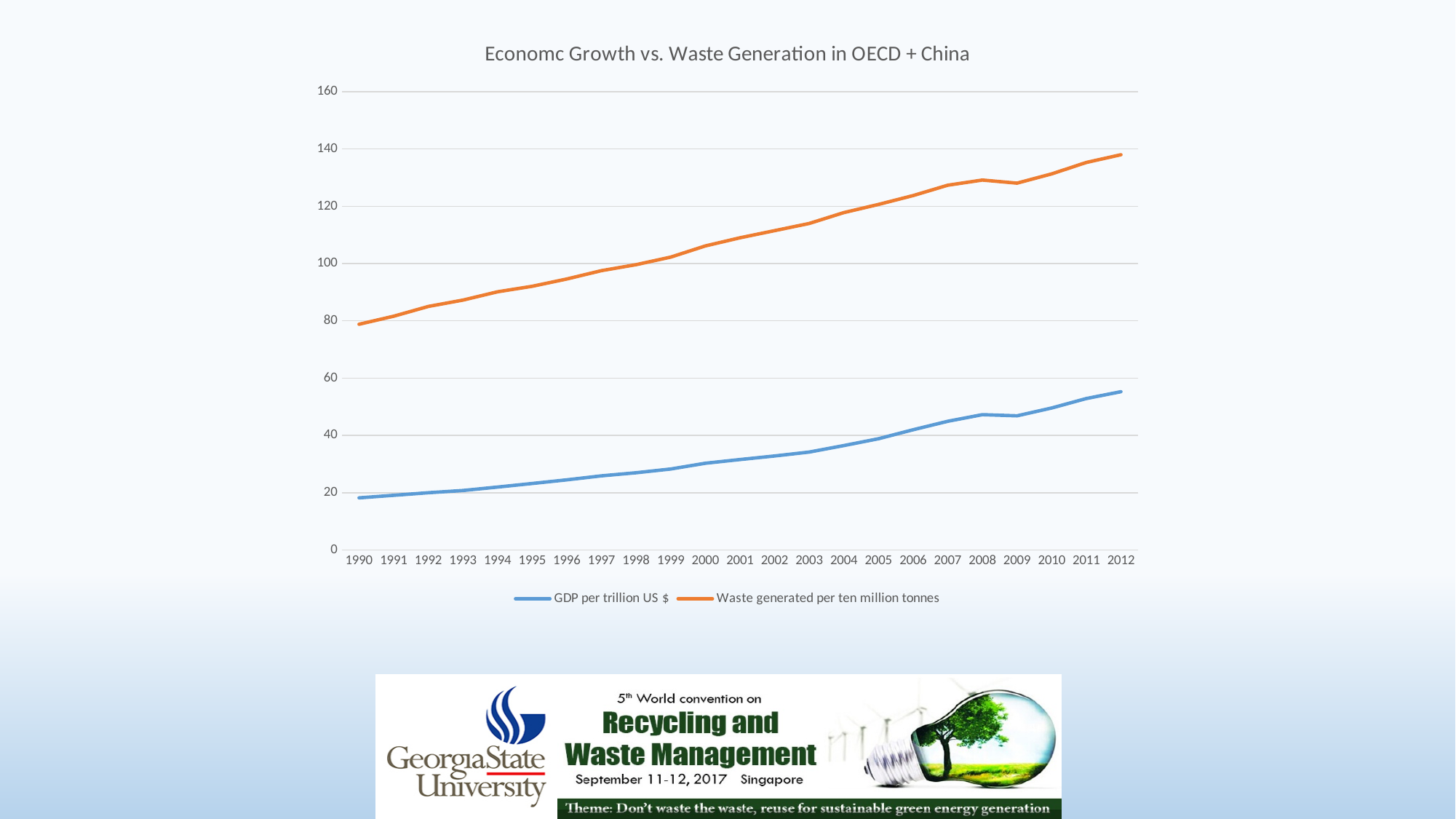
Is the value for GDP per trillion US $ in 2012 greater or less than 60? less Which series is drawn in orange? Waste generated per ten million tonnes Is the value for Waste generated per ten million tonnes in 2012 greater or less than 140? less In which year is the Waste generated per ten million tonnes series highest? 2012 What is the title of the chart? Economc Growth vs. Waste Generation in OECD + China How many years are plotted along the x axis? 23 In which year is the GDP per trillion US $ series lowest? 1990 Does the GDP per trillion US $ series generally rise or fall from 1990 to 2012? rise How many series does the legend list? 2 Is the value for Waste generated per ten million tonnes in 2000 greater or less than 100? greater In 2005, which series has the larger value, GDP per trillion US $ or Waste generated per ten million tonnes? Waste generated per ten million tonnes What kind of chart is shown on the slide? line chart